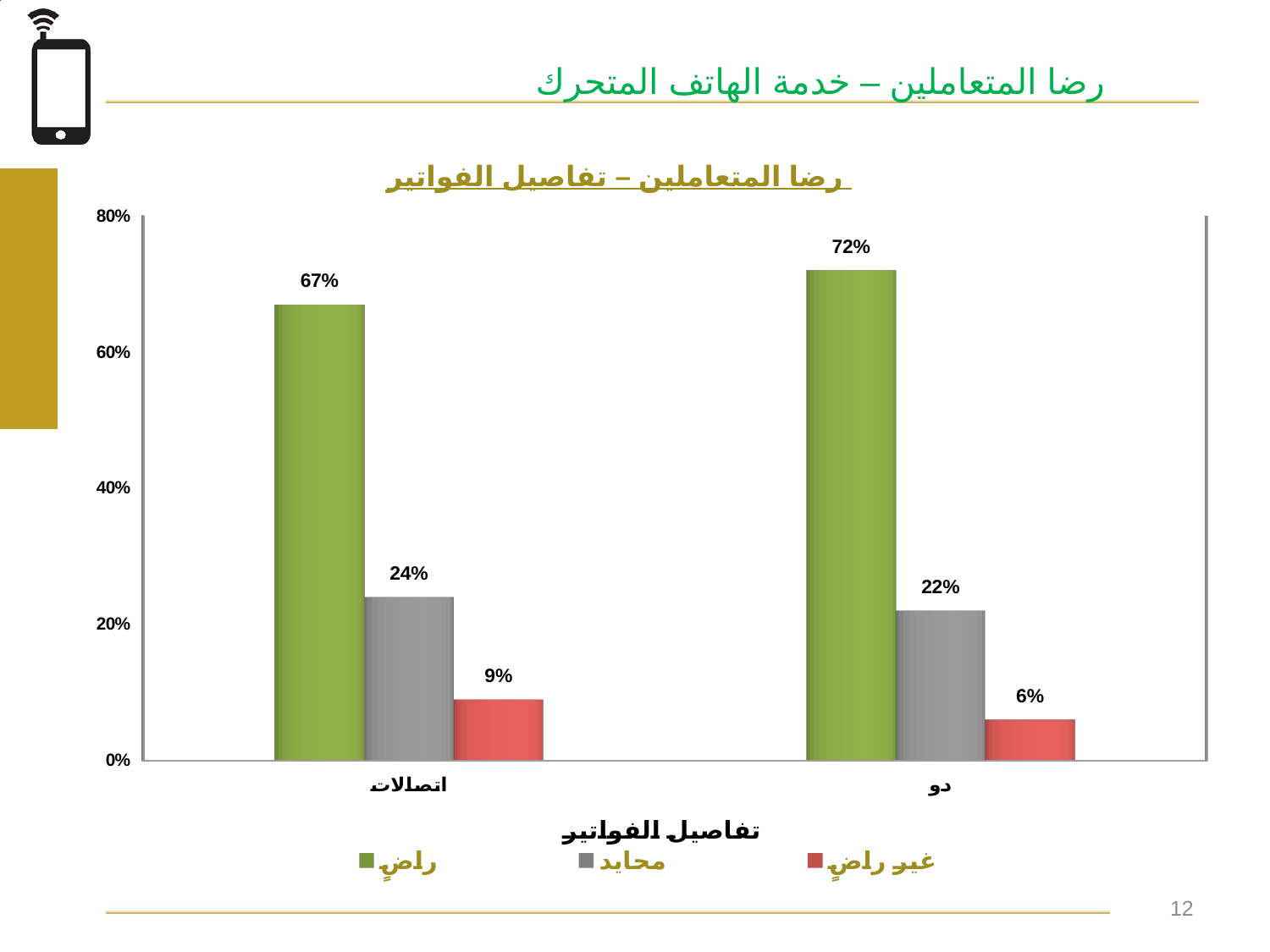
What kind of chart is shown on the slide? Bar chart How many series does the legend list? 3 What is the value of the محايد (grey) series for اتصالات? 24% What is the value of the غير راضٍ (red) series for دو? 6% Which category has the higher value for the راضٍ series, اتصالات or دو? دو What is the difference between the محايد values for اتصالات and دو? 2% What is the value of the راضٍ (green) series for دو? 72% What is the difference between the راضٍ values for دو and اتصالات? 5% What is the title of the chart? رضا المتعاملين – تفاصيل الفواتير What is the value of the راضٍ (green) series for اتصالات? 67% How many categories are shown on the x axis? 2 Which category has the lowest value for the غير راضٍ series? دو